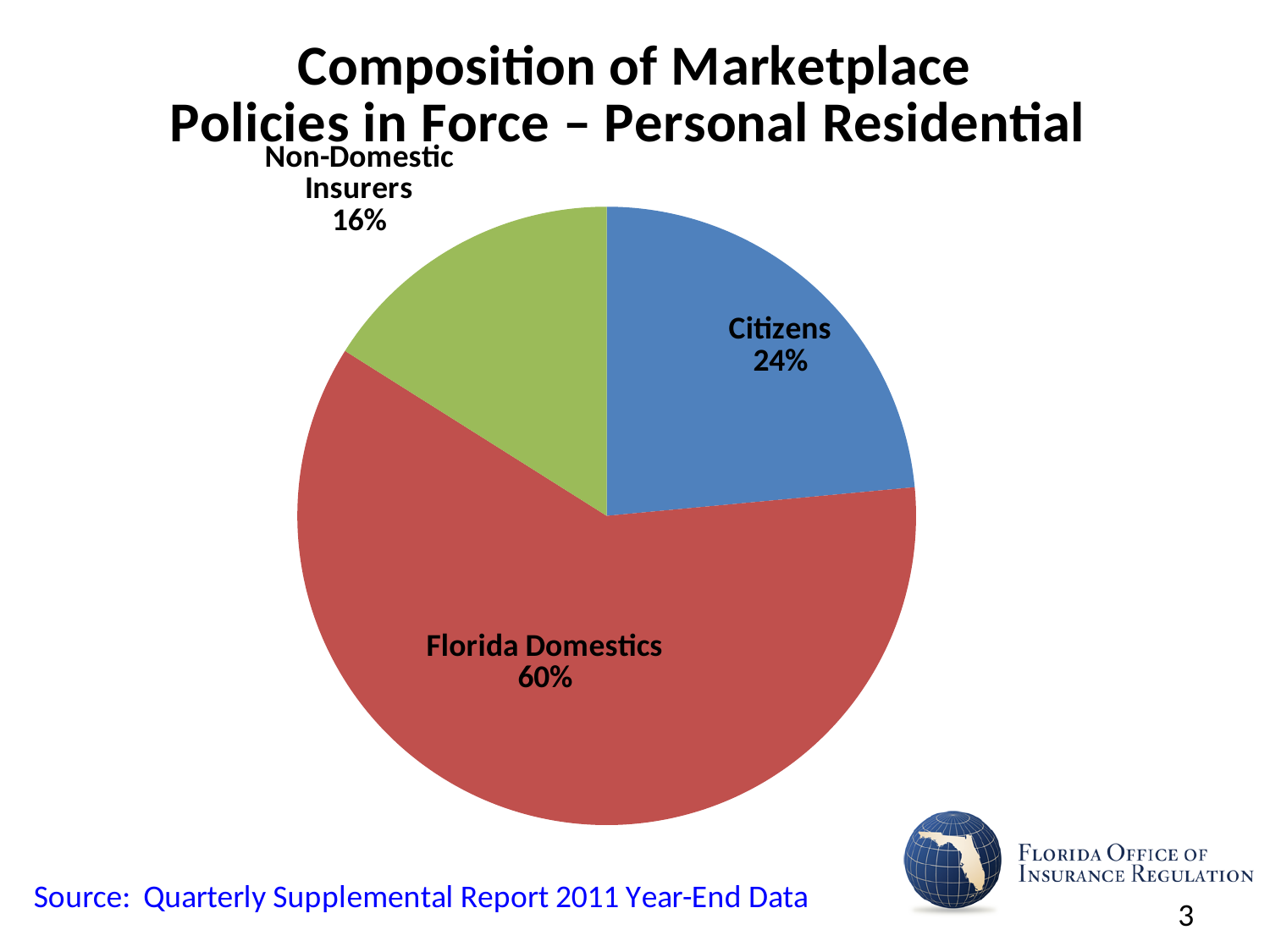
What is the difference in percentage points between Florida Domestics and Citizens? 36 What share of policies in force does Citizens hold? 24% How many slices does the pie chart have? 3 Which category has the smallest share of the pie? Non-Domestic Insurers What is the source cited for the chart data? Quarterly Supplemental Report 2011 Year-End Data What kind of chart is shown on the slide? Pie chart What share of policies in force do Florida Domestics hold? 60% What share of policies in force do Non-Domestic Insurers hold? 16% What is the difference in percentage points between Citizens and Non-Domestic Insurers? 8 What colour is the Florida Domestics slice? Red Which has a larger share, Citizens or Non-Domestic Insurers? Citizens Which category has the largest share of the pie? Florida Domestics